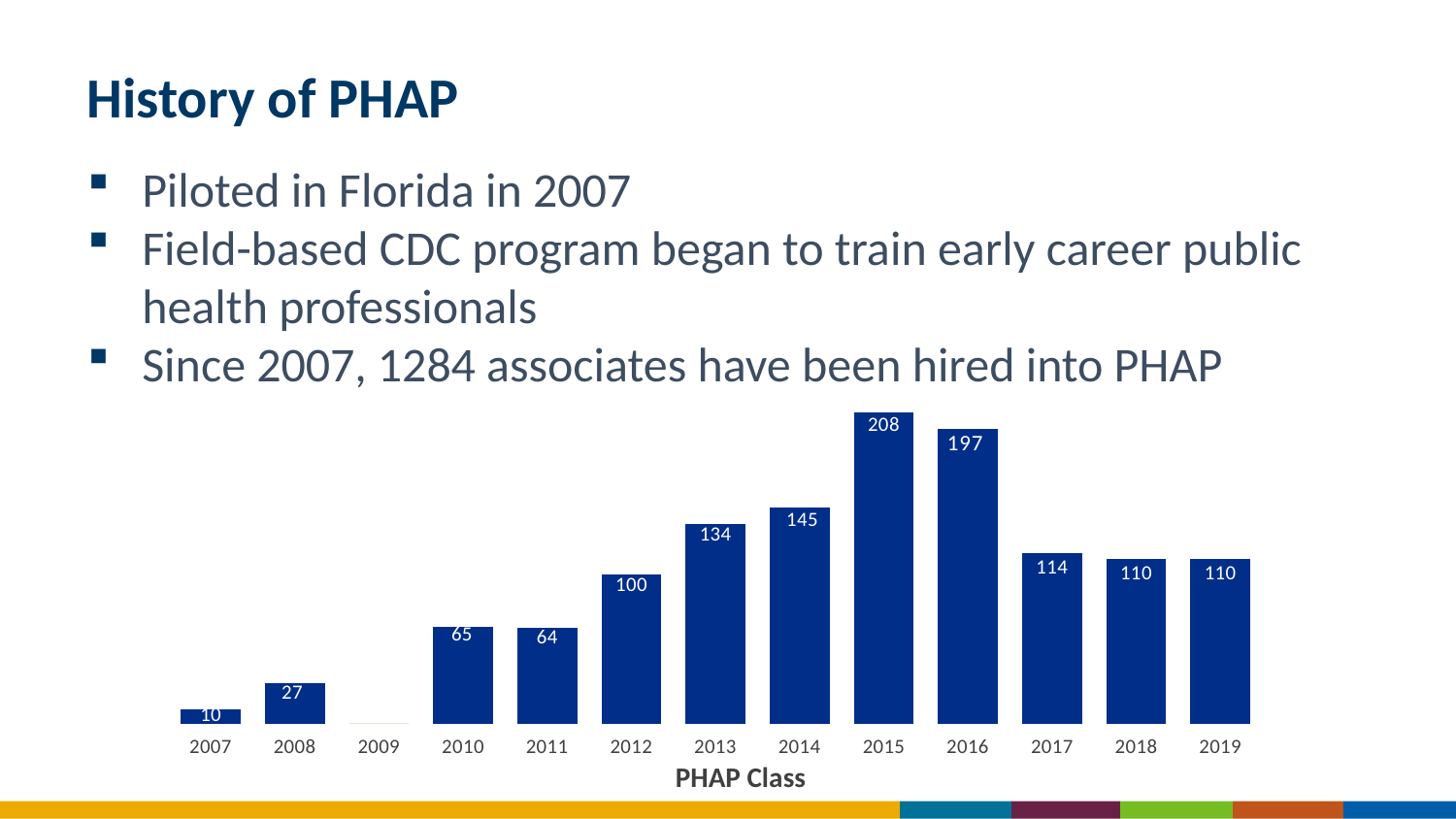
Do the values rise or fall from the 2015 PHAP Class to the 2019 PHAP Class? fall What is the title of the x axis of the chart? PHAP Class What is the value for the 2012 PHAP Class? 100 Which PHAP Class year has the highest value? 2015 What kind of chart is shown on the slide? bar chart What is the value for the 2008 PHAP Class? 27 What is the value for the 2019 PHAP Class? 110 How many PHAP Class years are shown on the x axis? 13 Which is larger, the value for the 2013 PHAP Class or the 2017 PHAP Class? 2013 What is the value for the 2015 PHAP Class? 208 What is the difference between the values for the 2014 and 2013 PHAP Classes? 11 What is the difference between the values for the 2015 and 2016 PHAP Classes? 11